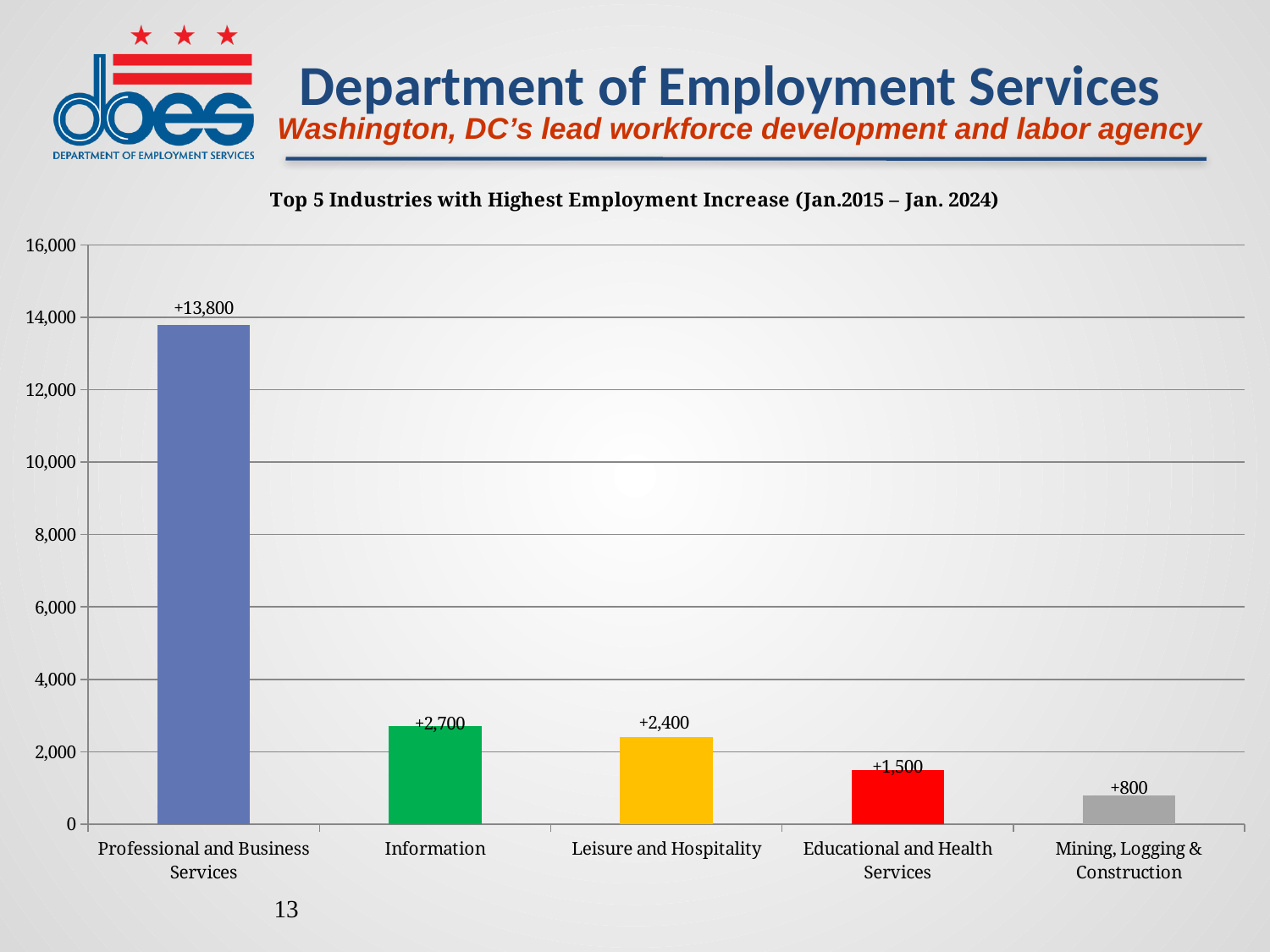
What is the difference between the employment increase for Professional and Business Services and for Educational and Health Services? 12,300 How many industries are shown in the chart? 5 What is the employment increase shown for Mining, Logging & Construction? +800 Which industry has the highest employment increase? Professional and Business Services Which has a larger employment increase, Leisure and Hospitality or Educational and Health Services? Leisure and Hospitality What is the title of the chart? Top 5 Industries with Highest Employment Increase (Jan.2015 – Jan. 2024) Is the value for Educational and Health Services greater or less than 2,000? less What is the difference between the employment increase for Information and for Leisure and Hospitality? 300 What is the employment increase shown for Information? +2,700 What is the employment increase shown for Professional and Business Services? +13,800 Which industry has the lowest employment increase? Mining, Logging & Construction What kind of chart is shown on the slide? Bar chart